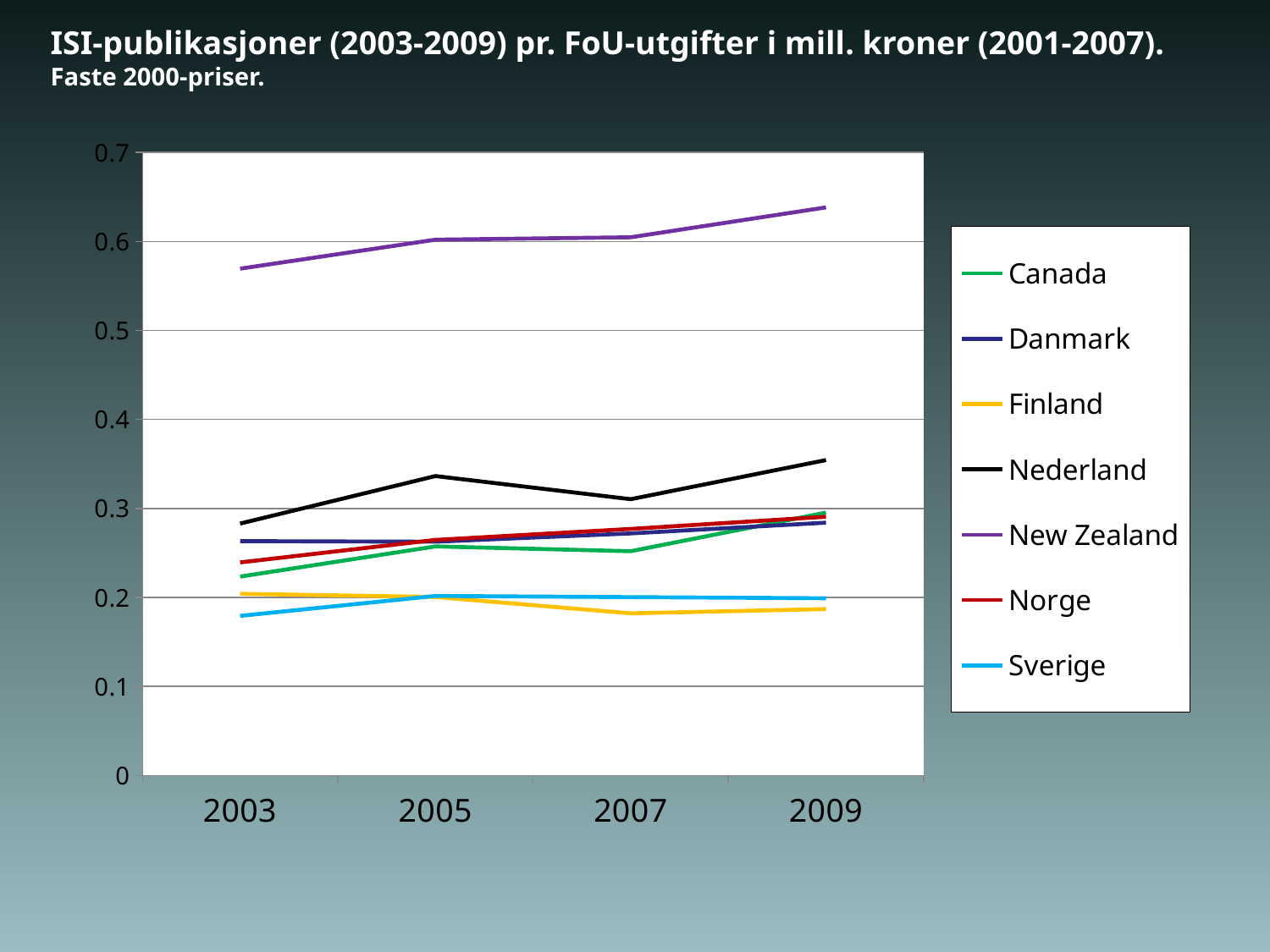
How many series does the legend list? 7 How many years are shown along the x axis? 4 In 2007, which is larger: the value for Nederland or the value for Canada? Nederland Is the value for Finland in 2007 greater or less than 0.2? less Does the line for New Zealand rise or fall from 2003 to 2009? rise Is the value for New Zealand in 2009 greater or less than 0.6? greater Which country has the highest value in 2009? New Zealand Is the value for Nederland in 2005 greater or less than 0.3? greater What colour is the line for New Zealand in the legend? purple Which country has the lowest value in 2003? Sverige What kind of chart is shown on the slide? line chart